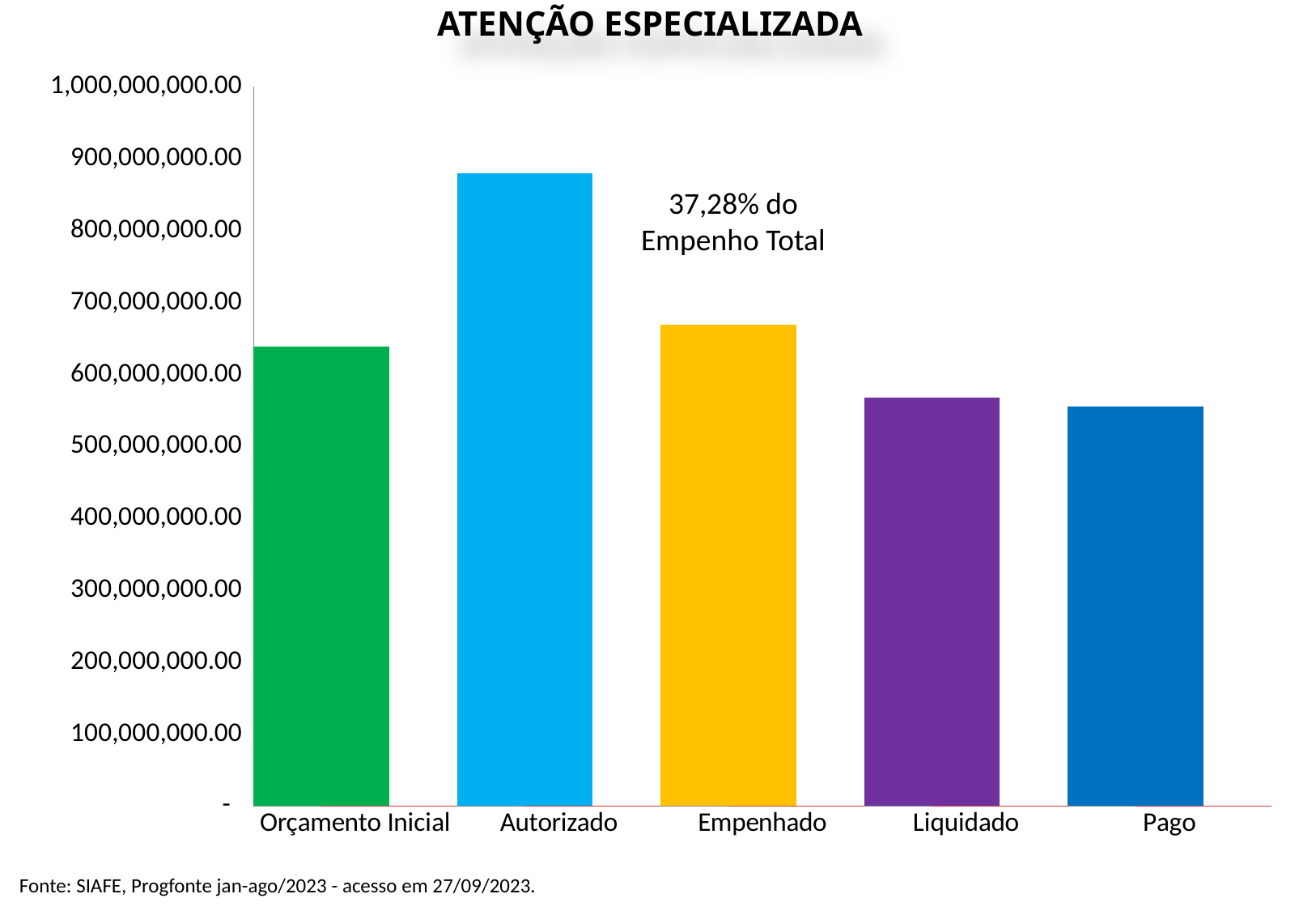
What percentage annotation is printed next to the Empenhado bar? 37,28% do Empenho Total Which is larger, the value for Empenhado or the value for Liquidado? Empenhado Is the value for Orçamento Inicial greater or less than 600,000,000.00? greater Is the value for Autorizado greater or less than 800,000,000.00? greater Is the value for Empenhado greater or less than 700,000,000.00? less How many categories are shown on the x axis of the chart? 5 What is the title of the chart? ATENÇÃO ESPECIALIZADA Which category has the highest value in the chart? Autorizado What kind of chart is shown on the slide? bar chart Which is larger, the value for Autorizado or the value for Empenhado? Autorizado